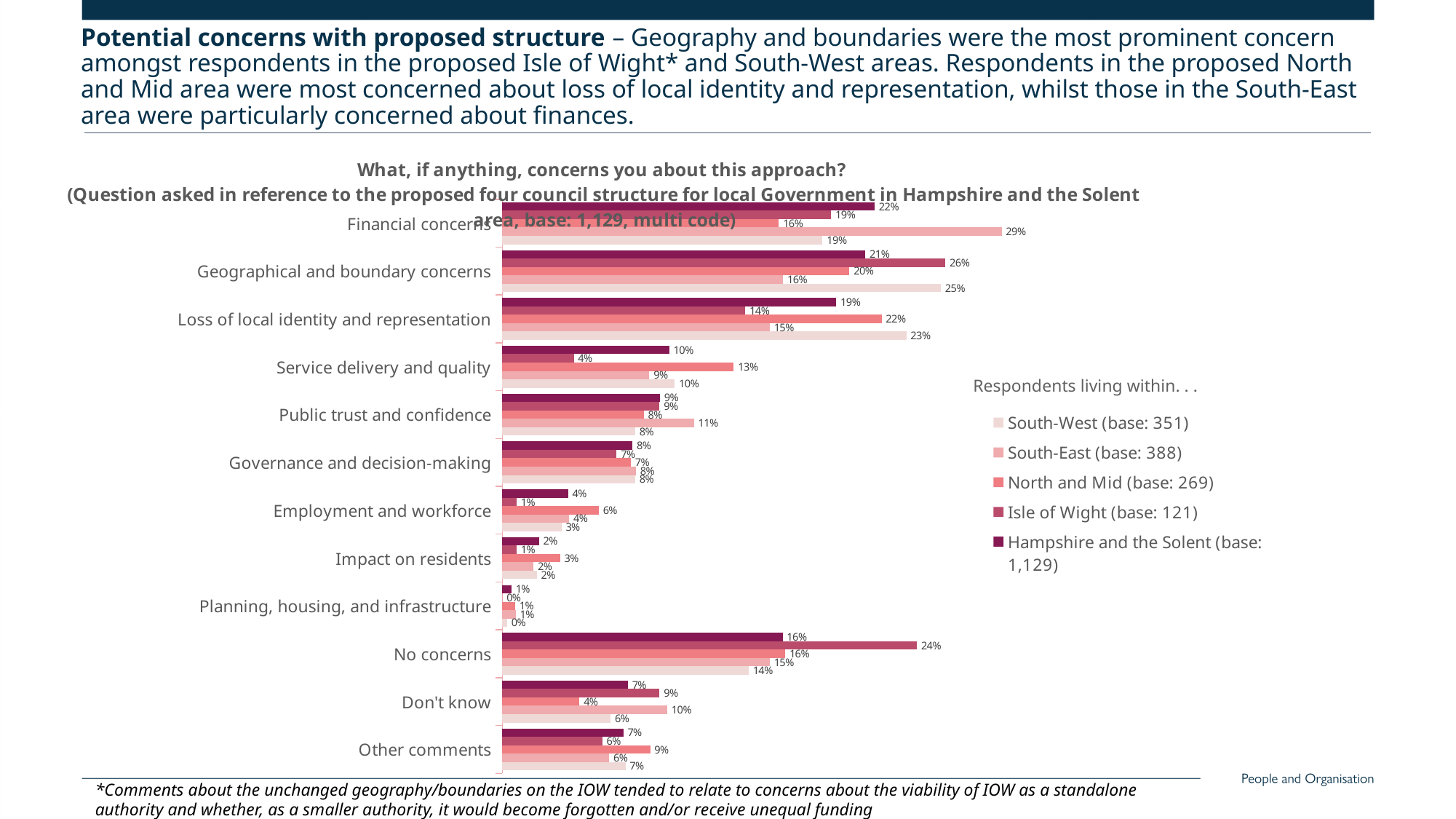
Which area has the highest value for Financial concerns? South-East What percentage of Isle of Wight respondents cited Geographical and boundary concerns? 26% What percentage of Isle of Wight respondents said they had No concerns? 24% How many concern categories are plotted on the chart? 12 What percentage of North and Mid respondents cited Loss of local identity and representation? 22% What kind of chart is shown on the slide? Bar chart What percentage of South-East respondents cited Financial concerns? 29% How many series does the legend list? 5 Which area has the lowest value for Service delivery and quality? Isle of Wight For Don't know, which is larger: the South-East value or the North and Mid value? South-East What is the base for the Hampshire and the Solent series shown in the legend? 1,129 What is the difference between the South-East and North and Mid values for Financial concerns? 13%